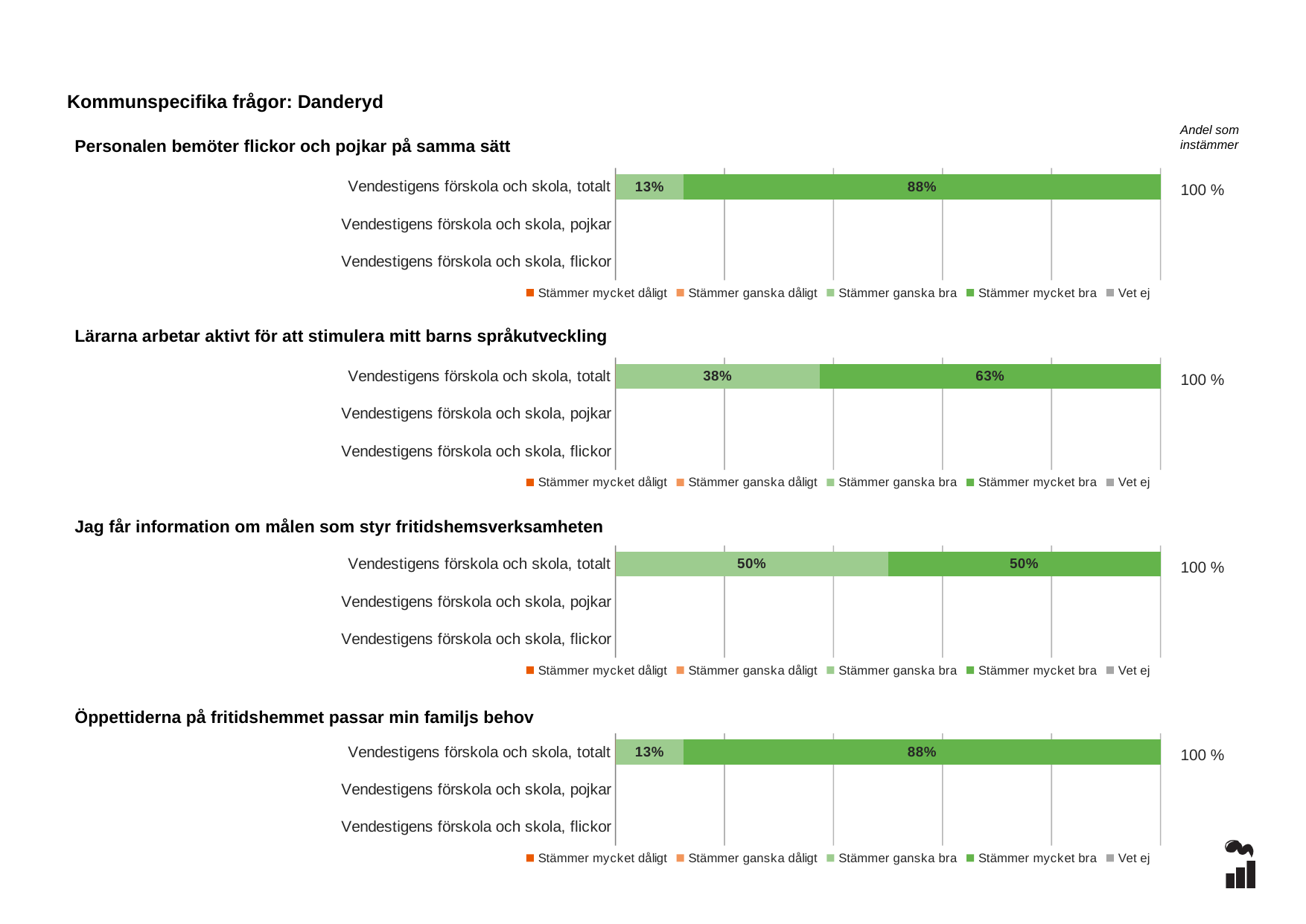
In the chart 'Öppettiderna på fritidshemmet passar min familjs behov', what percentage of 'Vendestigens förskola och skola, totalt' answered 'Stämmer ganska bra'? 13% What kind of chart is used for 'Lärarna arbetar aktivt för att stimulera mitt barns språkutveckling'? Stacked bar chart In the chart 'Lärarna arbetar aktivt för att stimulera mitt barns språkutveckling', what percentage of 'Vendestigens förskola och skola, totalt' answered 'Stämmer mycket bra'? 63% In the chart 'Jag får information om målen som styr fritidshemsverksamheten', what percentage of 'Vendestigens förskola och skola, totalt' answered 'Stämmer mycket bra'? 50% In the chart 'Personalen bemöter flickor och pojkar på samma sätt', which is larger for 'Vendestigens förskola och skola, totalt': 'Stämmer ganska bra' or 'Stämmer mycket bra'? Stämmer mycket bra In the chart 'Lärarna arbetar aktivt för att stimulera mitt barns språkutveckling', what is the difference between the 'Stämmer mycket bra' and 'Stämmer ganska bra' shares for 'Vendestigens förskola och skola, totalt'? 25 percentage points How many categories (rows) are shown in the chart 'Jag får information om målen som styr fritidshemsverksamheten'? 3 In the chart 'Personalen bemöter flickor och pojkar på samma sätt', what percentage of 'Vendestigens förskola och skola, totalt' answered 'Stämmer ganska bra'? 13% In the chart 'Personalen bemöter flickor och pojkar på samma sätt', what percentage of 'Vendestigens förskola och skola, totalt' answered 'Stämmer mycket bra'? 88% In the chart 'Lärarna arbetar aktivt för att stimulera mitt barns språkutveckling', what percentage of 'Vendestigens förskola och skola, totalt' answered 'Stämmer ganska bra'? 38% How many series does the legend of the chart 'Öppettiderna på fritidshemmet passar min familjs behov' list? 5 In the chart 'Öppettiderna på fritidshemmet passar min familjs behov', what is the 'Andel som instämmer' value shown for 'Vendestigens förskola och skola, totalt'? 100 %